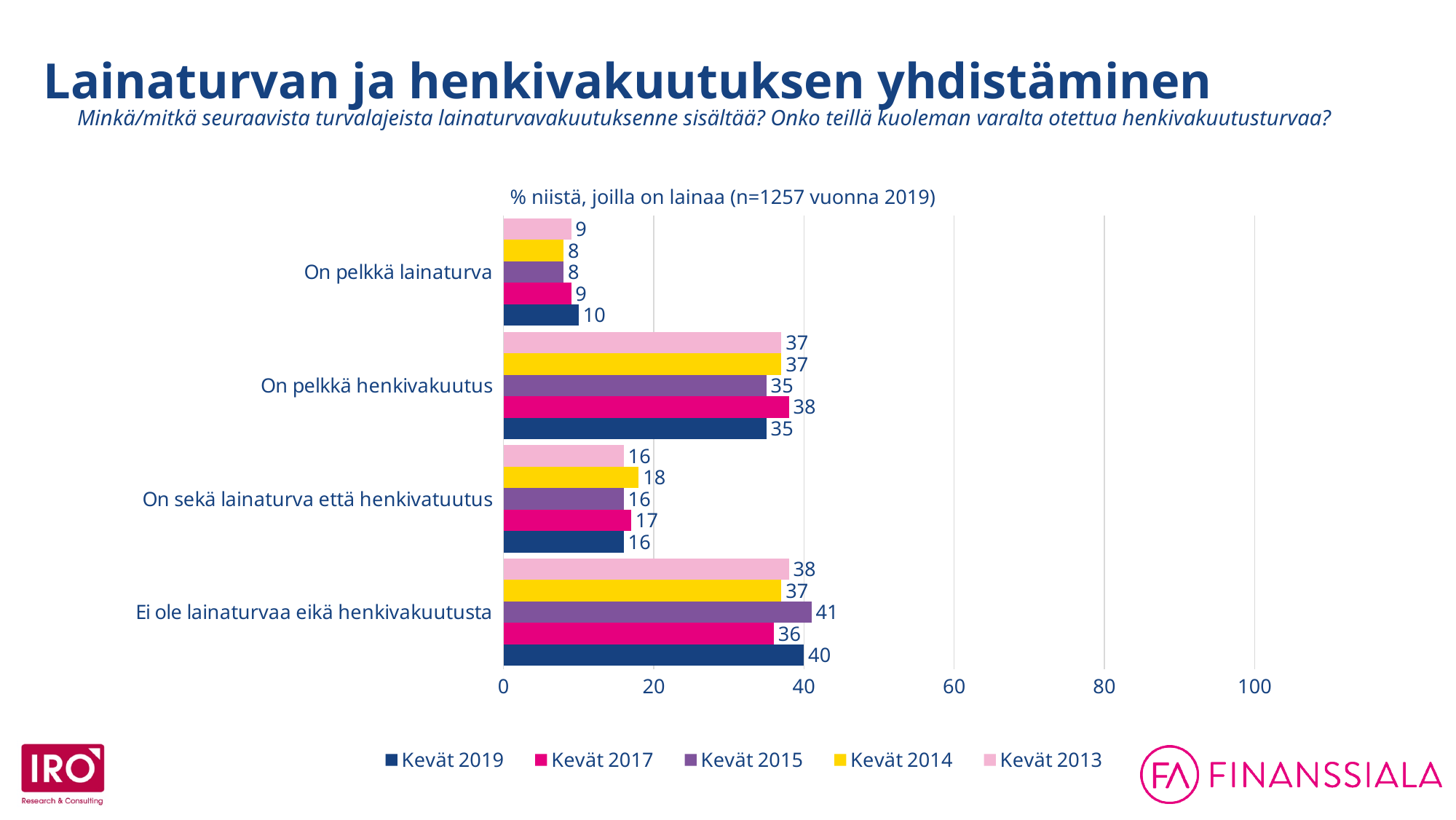
What is the value for Kevät 2017 in the category "On pelkkä henkivakuutus"? 38 How many series does the legend list? 5 What is the difference between the Kevät 2019 and Kevät 2017 values in the category "Ei ole lainaturvaa eikä henkivakuutusta"? 4 Is the Kevät 2019 value for "Ei ole lainaturvaa eikä henkivakuutusta" greater or less than 20? greater In the category "On pelkkä henkivakuutus", which is larger: the Kevät 2017 value or the Kevät 2019 value? Kevät 2017 Which category has the highest value for Kevät 2015? Ei ole lainaturvaa eikä henkivakuutusta What is the value for Kevät 2019 in the category "On pelkkä lainaturva"? 10 What kind of chart is shown on the slide? bar chart Which category has the lowest value for Kevät 2019? On pelkkä lainaturva What is the value for Kevät 2014 in the category "On sekä lainaturva että henkivatuutus"? 18 What is the value for Kevät 2015 in the category "Ei ole lainaturvaa eikä henkivakuutusta"? 41 How many categories are shown on the chart? 4